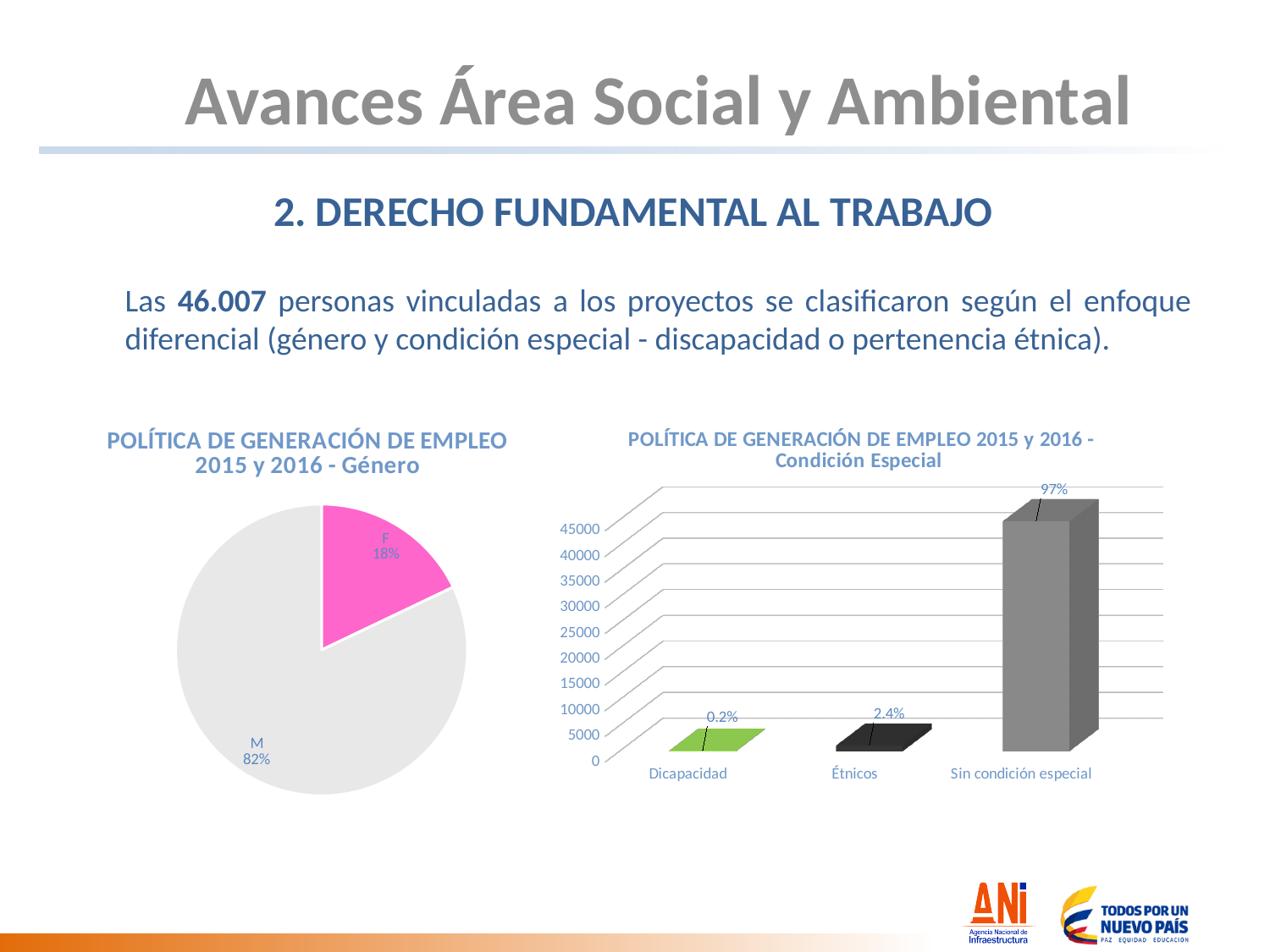
In the bar chart on the right, is the value for Sin condición especial greater or less than 30000? greater In the bar chart on the right, what label is shown on the bar for Étnicos? 2.4% In the bar chart on the right, what label is shown on the bar for Dicapacidad? 0.2% In the bar chart on the right, which category has the lowest bar? Dicapacidad In the pie chart on the left, which slice is larger, F or M? M In the pie chart on the left, what share is labelled for M? 82% In the pie chart on the left, what share is labelled for F? 18% In the bar chart on the right, which category has the highest bar? Sin condición especial In the bar chart on the right, what label is shown on the bar for Sin condición especial? 97% What kind of chart is the one titled 'POLÍTICA DE GENERACIÓN DE EMPLEO 2015 y 2016 - Género'? Pie chart What kind of chart is the one titled 'POLÍTICA DE GENERACIÓN DE EMPLEO 2015 y 2016 - Condición Especial'? Bar chart In the pie chart on the left, how many slices are there? 2